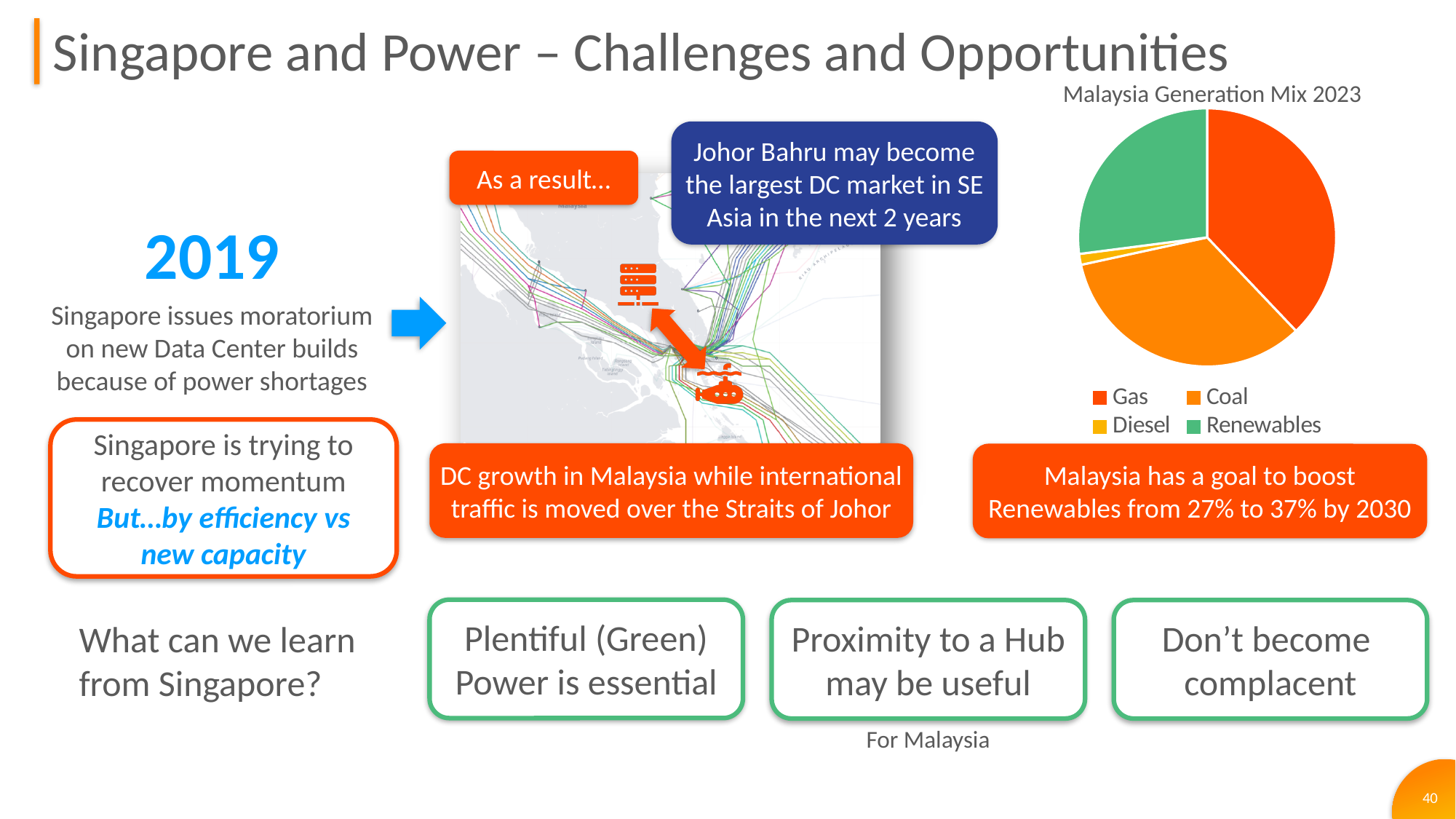
How many categories does the Malaysia Generation Mix 2023 pie chart show? 4 In the Malaysia Generation Mix 2023 pie chart, which is larger, Renewables or Diesel? Renewables What kind of chart is the Malaysia Generation Mix 2023 chart? Pie chart Which category has the smallest slice in the Malaysia Generation Mix 2023 pie chart? Diesel What colour represents Renewables in the Malaysia Generation Mix 2023 pie chart? Green In the Malaysia Generation Mix 2023 pie chart, which is larger, Gas or Coal? Gas How many entries does the legend of the Malaysia Generation Mix 2023 chart list? 4 What is the title of the pie chart on the slide? Malaysia Generation Mix 2023 In the Malaysia Generation Mix 2023 pie chart, which is larger, Gas or Renewables? Gas Which category has the largest slice in the Malaysia Generation Mix 2023 pie chart? Gas